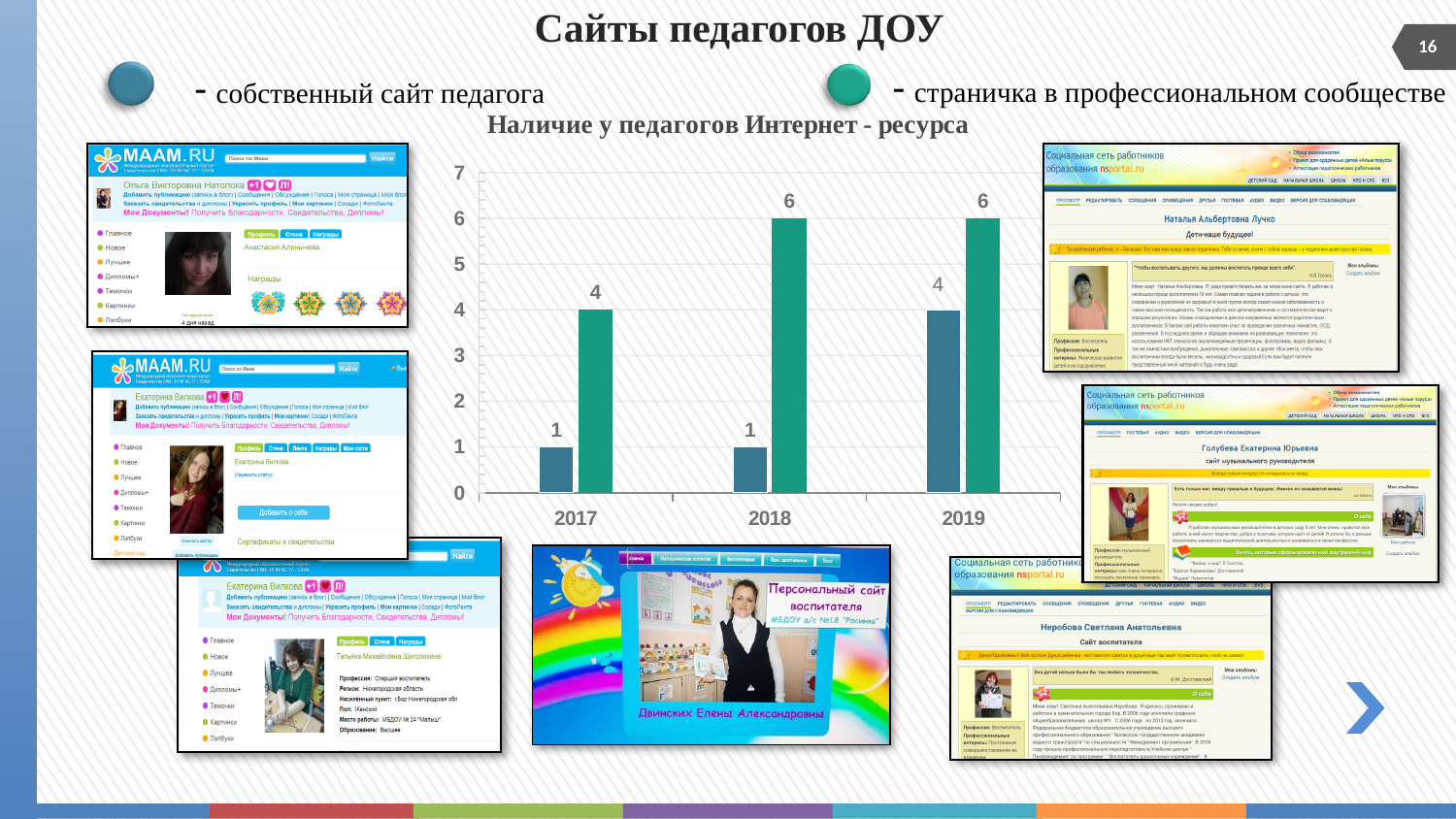
Which is larger in 2019: the green bar or the dark teal bar? the green bar What is the highest value shown on the chart's y axis? 7 What is the value of the dark teal bar (собственный сайт педагога) for 2017? 1 What is the value of the green bar (страничка в профессиональном сообществе) for 2017? 4 How many years are shown on the x axis of the chart? 3 Does the value of the green bar (страничка в профессиональном сообществе) rise or fall from 2017 to 2018? rise What is the title of the chart on the slide? Наличие у педагогов Интернет - ресурса What is the value of the dark teal bar (собственный сайт педагога) for 2019? 4 What kind of chart is shown on the slide? bar chart What is the value of the green bar (страничка в профессиональном сообществе) for 2018? 6 In which year is the dark teal bar (собственный сайт педагога) highest? 2019 What is the difference between the green bar and the dark teal bar in 2018? 5